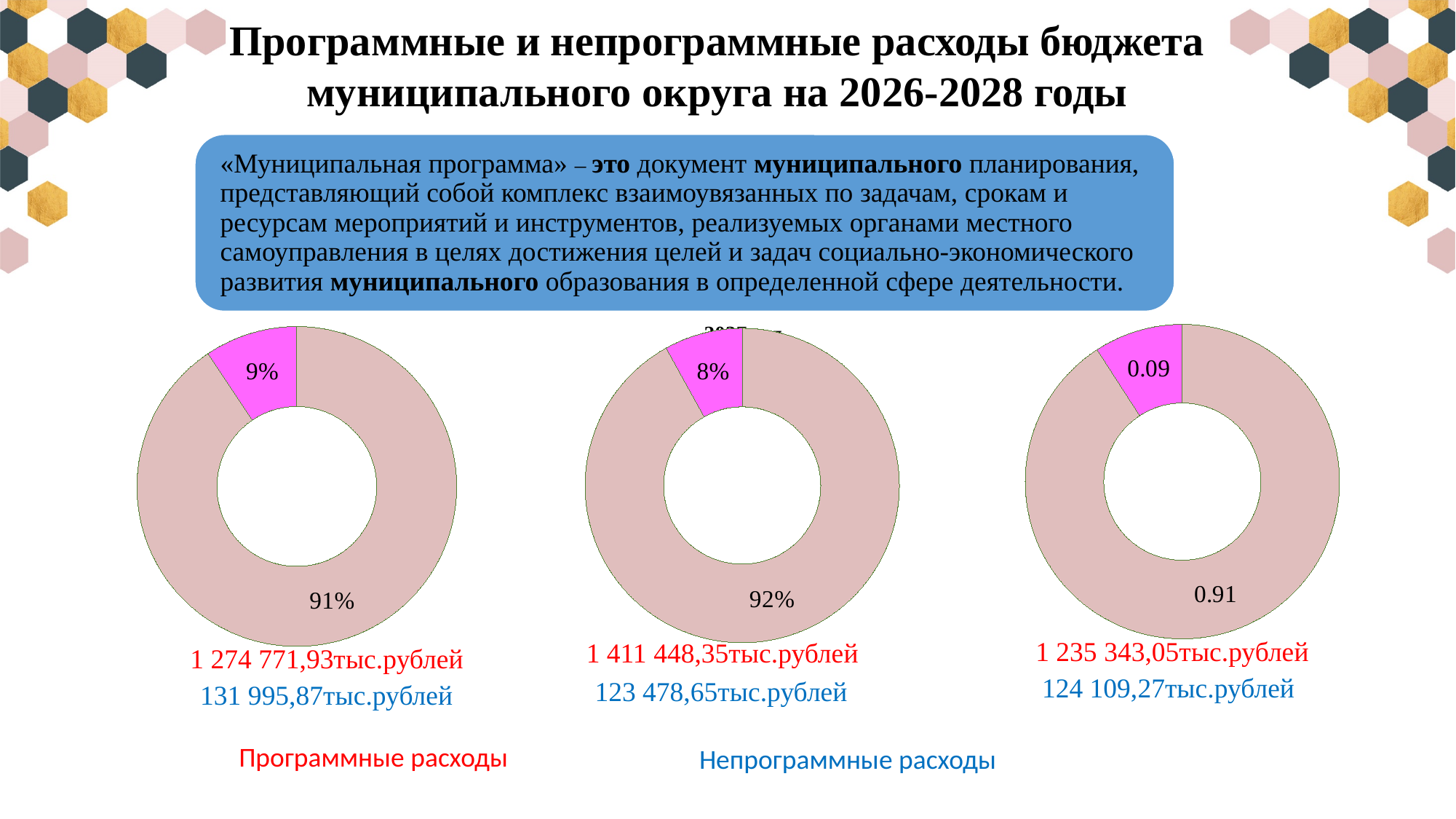
Which is larger: the smaller slice of the left chart (9%) or the smaller slice of the middle chart (8%)? The left chart's slice (9%) In the right donut chart, what value is shown on the smaller (magenta) slice? 0.09 How many donut charts are on the slide? 3 In the middle donut chart, what percentage is shown on the larger slice? 92% In the right donut chart, what value is shown on the larger slice? 0.91 In the middle donut chart, what is the difference between the larger slice (92%) and the smaller slice (8%)? 84% In the left donut chart, what percentage is shown on the smaller (magenta) slice? 9% In the left donut chart, what percentage is shown on the larger slice? 91% What kind of chart is used on this slide? Donut (pie) chart In the middle donut chart, what percentage is shown on the smaller (magenta) slice? 8% What colour is the smaller slice in each donut chart? Magenta How many slices does the left donut chart have? 2